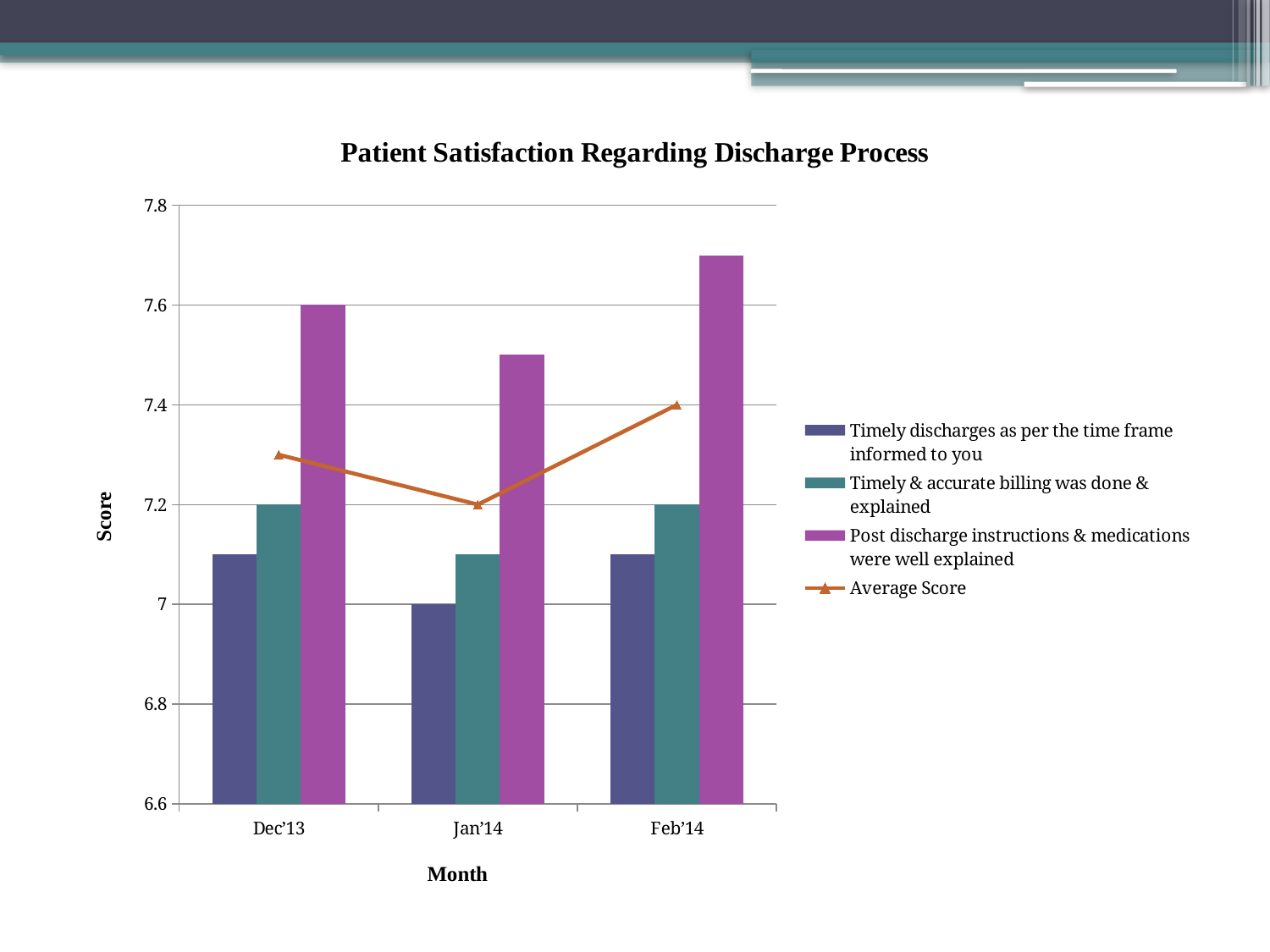
How many series does the legend list? 4 Which series has the lowest score in Jan'14? Timely discharges as per the time frame informed to you How many months are shown on the x axis? 3 What is the score for 'Post discharge instructions & medications were well explained' in Dec'13? 7.6 What is the Average Score for Feb'14? 7.4 In which month is the score for 'Post discharge instructions & medications were well explained' highest? Feb'14 What is the Average Score for Jan'14? 7.2 What is the score for 'Timely & accurate billing was done & explained' in Dec'13? 7.2 What is the score for 'Timely discharges as per the time frame informed to you' in Jan'14? 7 Is the score for 'Post discharge instructions & medications were well explained' in Feb'14 greater or less than 7.6? greater Which is larger in Dec'13: the score for 'Timely discharges as per the time frame informed to you' or for 'Timely & accurate billing was done & explained'? Timely & accurate billing was done & explained What is the title of the chart? Patient Satisfaction Regarding Discharge Process